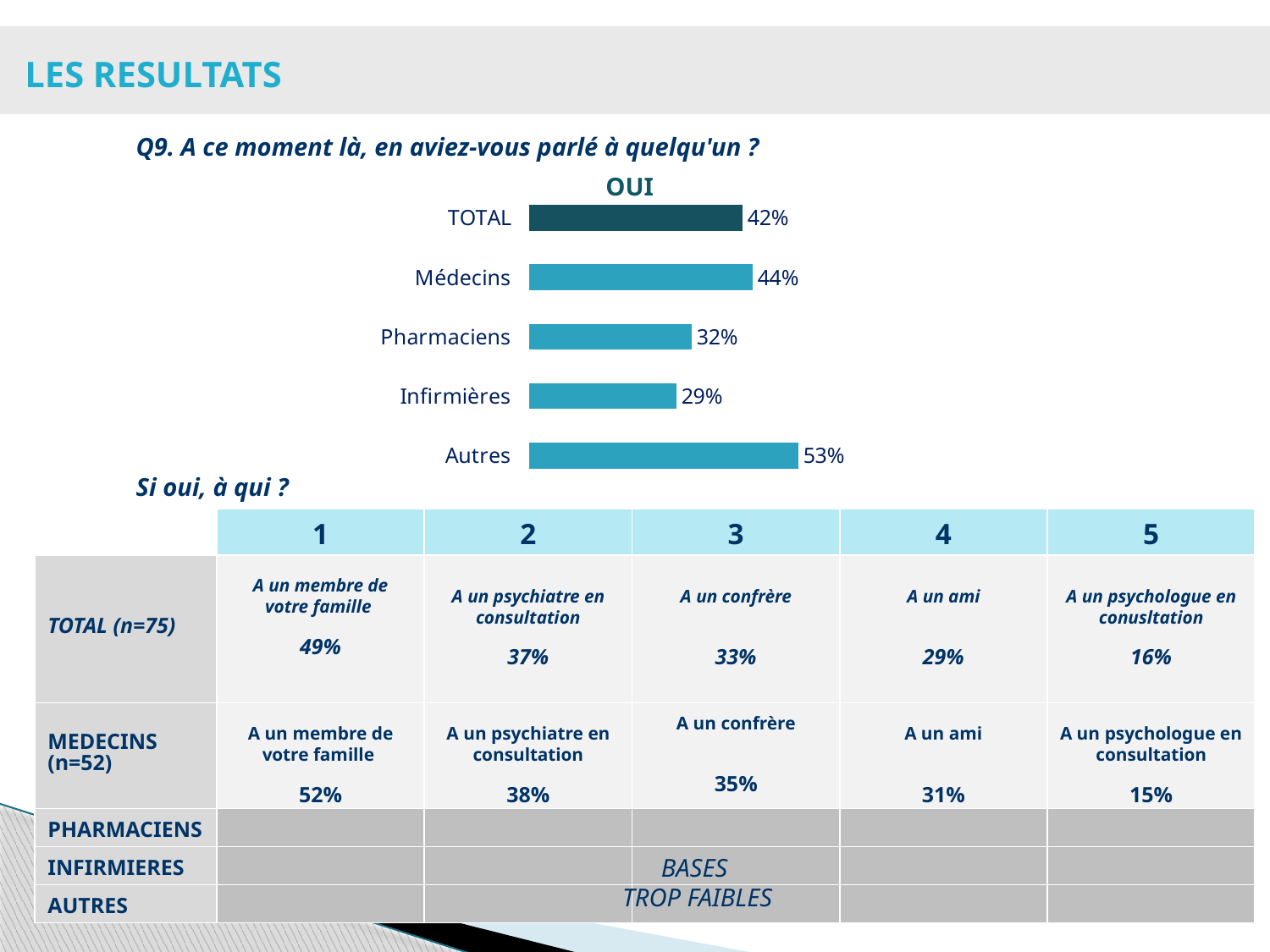
What is the title shown above the bar chart? OUI What is the value for Infirmières in the OUI bar chart? 29% What is the value for Médecins in the OUI bar chart? 44% What is the value for Pharmaciens in the OUI bar chart? 32% How many categories are shown in the OUI bar chart? 5 Which category has the lowest value in the OUI bar chart? Infirmières What is the value for TOTAL in the OUI bar chart? 42% Which category has the highest value in the OUI bar chart? Autres What is the difference between the values for Autres and Infirmières in the OUI bar chart? 24% What kind of chart is shown on the slide? Bar chart What is the difference between the values for Médecins and Pharmaciens in the OUI bar chart? 12% Which is larger in the OUI bar chart, Médecins or Pharmaciens? Médecins